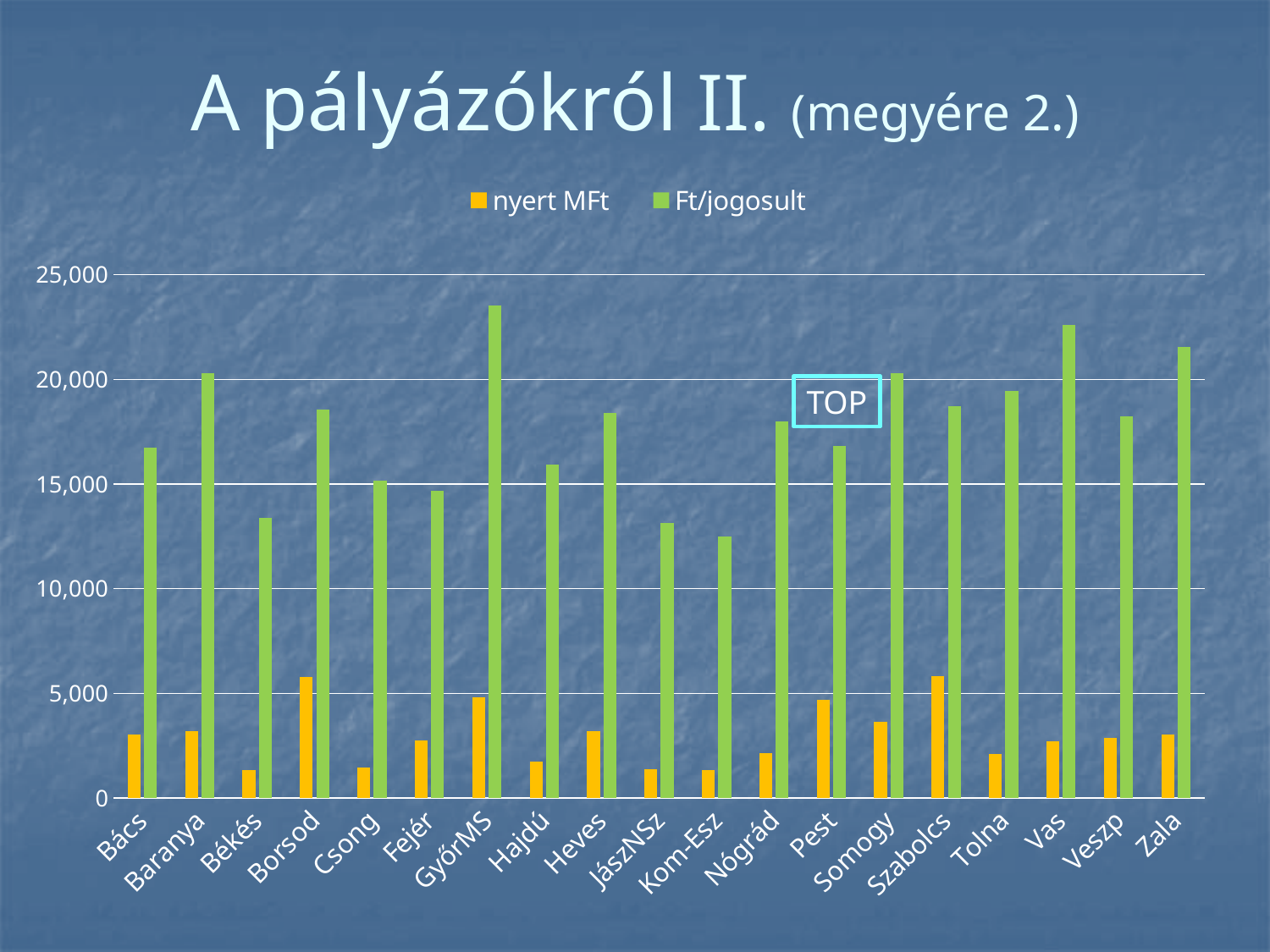
Is the Ft/jogosult value for GyőrMS greater or less than 20,000? greater Is the Ft/jogosult value for Zala greater or less than 20,000? greater Which county has the highest Ft/jogosult value? GyőrMS How many series does the legend list? 2 What is the title of the slide containing the chart? A pályázókról II. (megyére 2.) How many counties (categories) are shown on the x axis? 19 Which has the larger Ft/jogosult value, Pest or Somogy? Somogy Which has the larger Ft/jogosult value, Baranya or Békés? Baranya Is the nyert MFt value for Bács greater or less than 5,000? less What kind of chart is shown on the slide? bar chart Which series is shown in green in the legend? Ft/jogosult